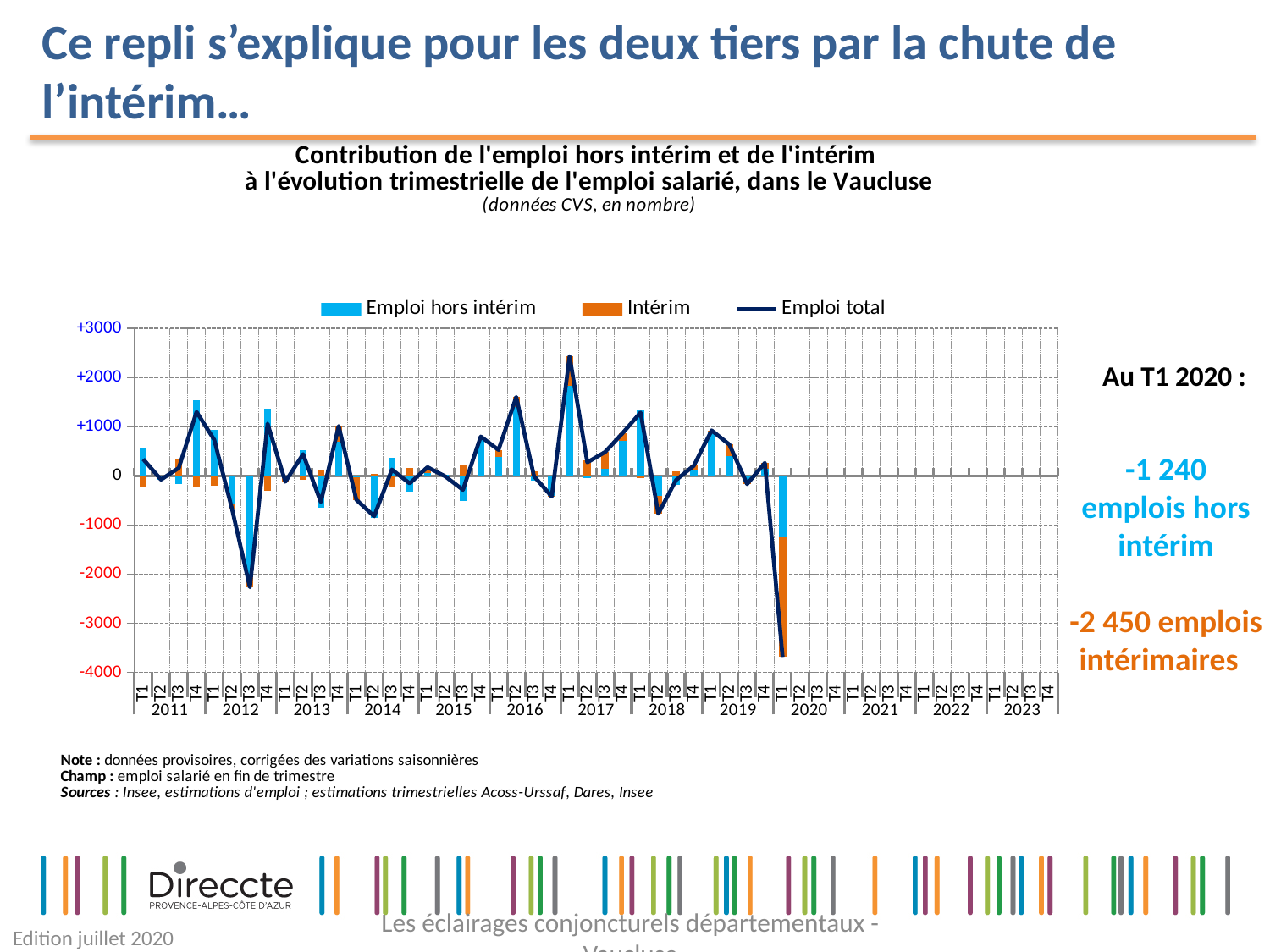
In which quarter does the Emploi total line reach its highest point? T1 2017 How many years are labelled along the x axis? 13 How many series does the legend list? 3 What is the value for Emploi hors intérim at T1 2020, as stated on the slide? -1 240 Using the two values printed for T1 2020, what is the combined change in employment (hors intérim plus intérim)? -3 690 Is the Emploi total value at T1 2020 greater or less than -3000? less Is the Emploi total value at T1 2017 greater or less than +2000? greater At T1 2020, which contribution is larger in magnitude: Emploi hors intérim or Intérim? Intérim Is the Emploi total value at T3 2012 greater or less than -2000? less In which quarter does the Emploi total line reach its lowest point? T1 2020 Which series is drawn as a dark line rather than as bars? Emploi total What is the value for Intérim at T1 2020, as stated on the slide? -2 450